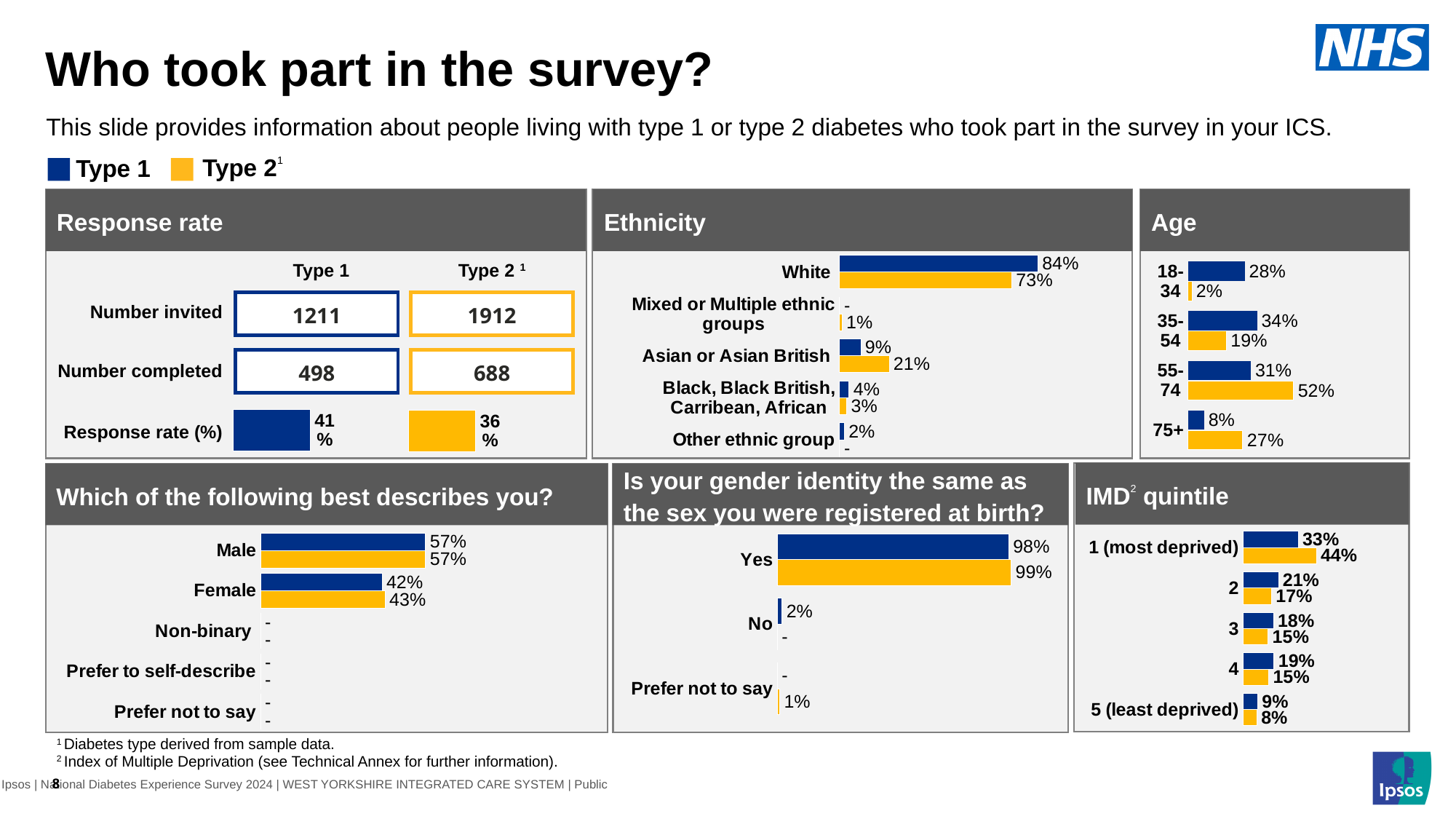
In the Age chart, what percentage of Type 2 respondents are aged 55-74? 52% In the 'Which of the following best describes you?' chart, is the Type 1 percentage for Male larger or smaller than the Type 1 percentage for Female? larger In the Age chart, which age group has the highest percentage of Type 1 respondents? 35-54 In the Ethnicity chart, what percentage of Type 1 respondents are White? 84% In the IMD quintile chart, what percentage of Type 2 respondents are in quintile 1 (most deprived)? 44% In the Ethnicity chart, what percentage of Type 2 respondents are Asian or Asian British? 21% In the Age chart, what is the difference between the Type 2 and Type 1 percentages for the 75+ age group? 19% In the Response rate panel, what is the response rate for Type 1? 41% In the 'Is your gender identity the same as the sex you were registered at birth?' chart, what percentage of Type 2 respondents answered Yes? 99% In the IMD quintile chart, which quintile has the lowest percentage of Type 1 respondents? 5 (least deprived) How many series does the legend at the top of the slide list? 2 In the Age chart, which age group has the lowest percentage of Type 2 respondents? 18-34